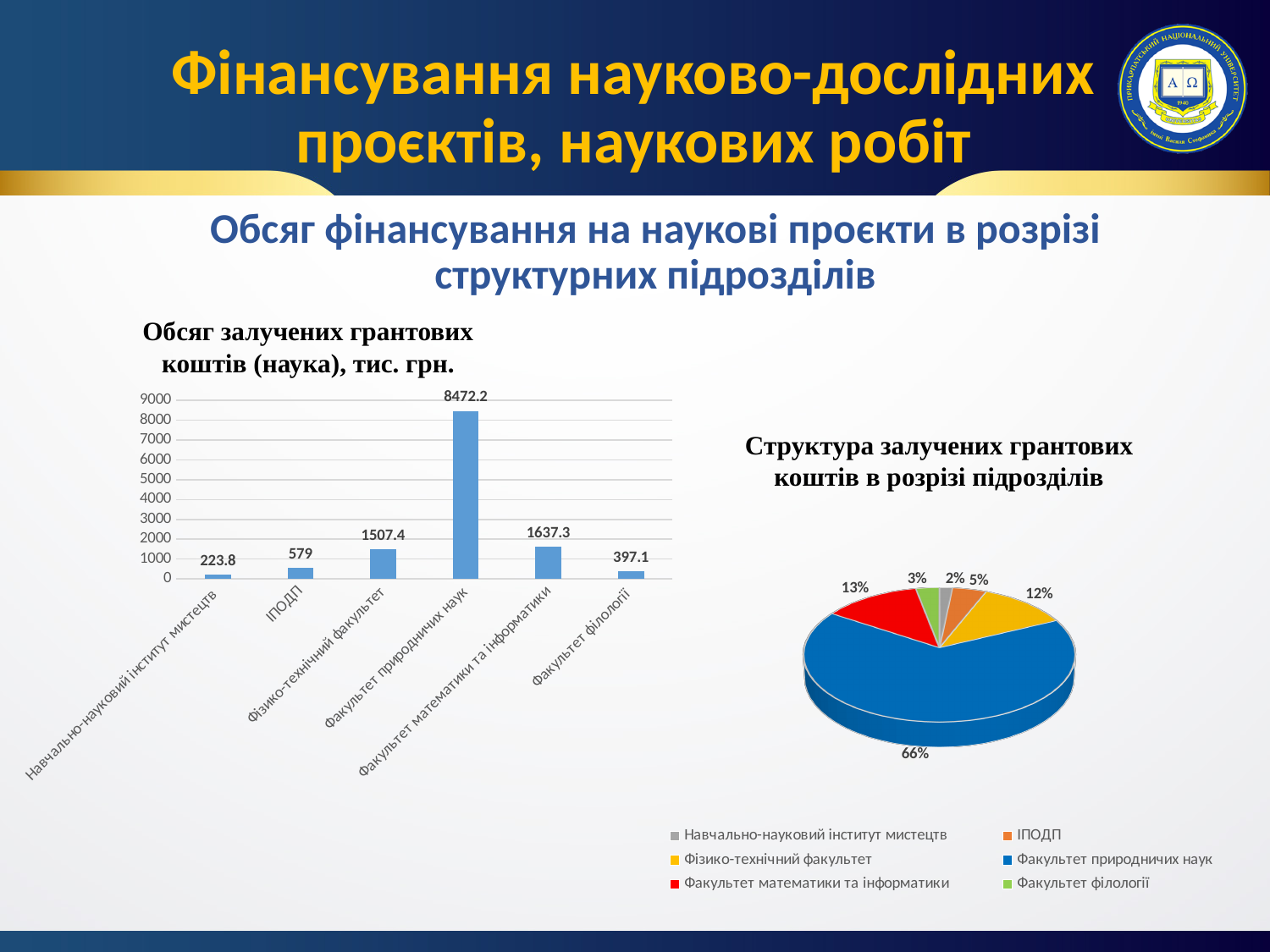
In the bar chart 'Обсяг залучених грантових коштів (наука), тис. грн.', what is the value for Факультет філології? 397.1 What type of chart is 'Обсяг залучених грантових коштів (наука), тис. грн.'? Bar chart In the pie chart 'Структура залучених грантових коштів в розрізі підрозділів', what share does Факультет математики та інформатики have? 13% In the bar chart 'Обсяг залучених грантових коштів (наука), тис. грн.', what is the value for ІПОДП? 579 How many entries does the legend of the pie chart 'Структура залучених грантових коштів в розрізі підрозділів' list? 6 How many categories are shown in the bar chart 'Обсяг залучених грантових коштів (наука), тис. грн.'? 6 In the pie chart 'Структура залучених грантових коштів в розрізі підрозділів', what share does Факультет природничих наук have? 66% In the bar chart 'Обсяг залучених грантових коштів (наука), тис. грн.', what is the difference between Факультет математики та інформатики and Фізико-технічний факультет? 129.9 In the bar chart 'Обсяг залучених грантових коштів (наука), тис. грн.', which category has the lowest value? Навчально-науковий інститут мистецтв In the bar chart 'Обсяг залучених грантових коштів (наука), тис. грн.', which is larger: ІПОДП or Факультет філології? ІПОДП In the bar chart 'Обсяг залучених грантових коштів (наука), тис. грн.', what is the value for Факультет природничих наук? 8472.2 In the bar chart 'Обсяг залучених грантових коштів (наука), тис. грн.', which category has the highest value? Факультет природничих наук